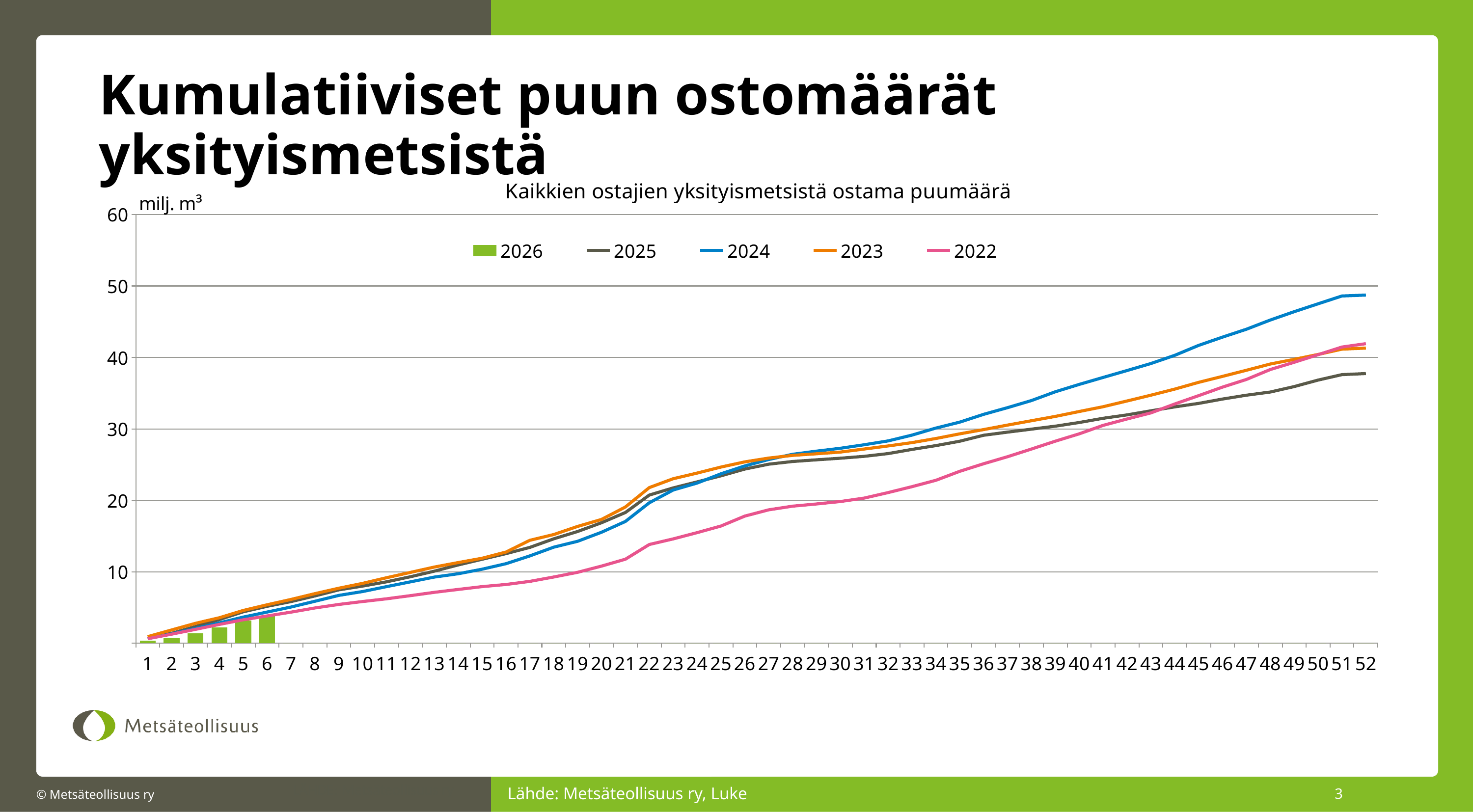
Is the value for 2024 at week 52 greater or less than 40? greater Which of the line series has the lowest value at week 52? 2025 At week 30, which is larger: the value for 2023 or the value for 2022? 2023 How many weeks are shown on the x axis? 52 Is the value for 2025 at week 52 greater or less than 40? less Is the value for 2022 at week 26 greater or less than 20? less What unit is shown on the y axis? milj. m³ Which series has the highest value at week 52? 2024 How many series does the legend list? 5 What is the title of the chart? Kaikkien ostajien yksityismetsistä ostama puumäärä What kind of chart is shown on the slide? A combined line and bar chart Do the values for the 2024 series rise or fall along the x axis? Rise